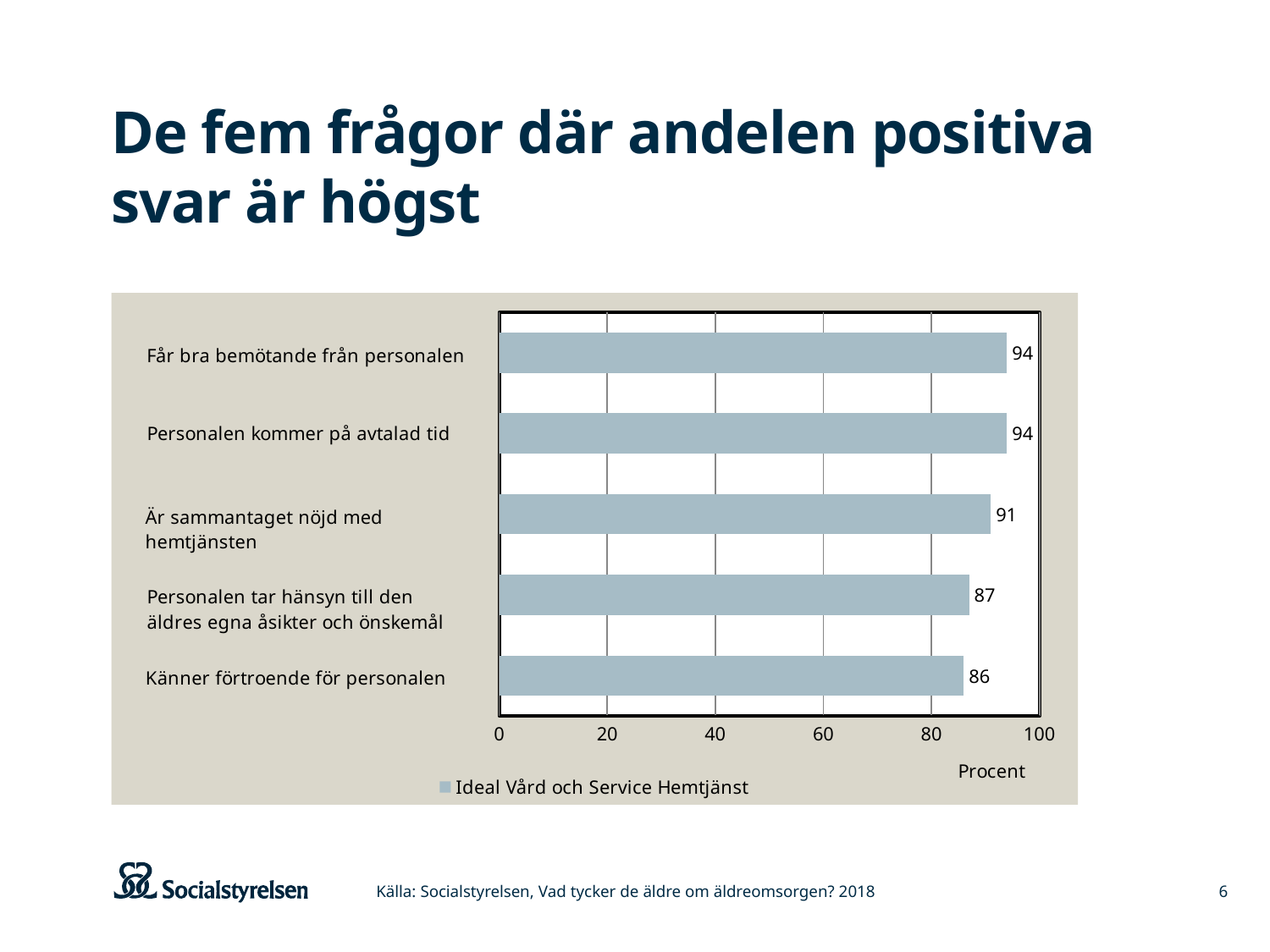
What is the difference between the values for "Personalen kommer på avtalad tid" and "Känner förtroende för personalen"? 8 Which is larger: the value for "Är sammantaget nöjd med hemtjänsten" or the value for "Känner förtroende för personalen"? Är sammantaget nöjd med hemtjänsten What series name does the legend show? Ideal Vård och Service Hemtjänst What is the difference between the values for "Är sammantaget nöjd med hemtjänsten" and "Personalen tar hänsyn till den äldres egna åsikter och önskemål"? 4 How many categories are shown in the chart? 5 Is the value for "Känner förtroende för personalen" greater or less than 80? greater Which category has the lowest value? Känner förtroende för personalen What is the value for "Personalen tar hänsyn till den äldres egna åsikter och önskemål"? 87 What is the value for "Känner förtroende för personalen"? 86 What is the value for "Får bra bemötande från personalen"? 94 What is the value for "Är sammantaget nöjd med hemtjänsten"? 91 What kind of chart is shown on the slide? bar chart